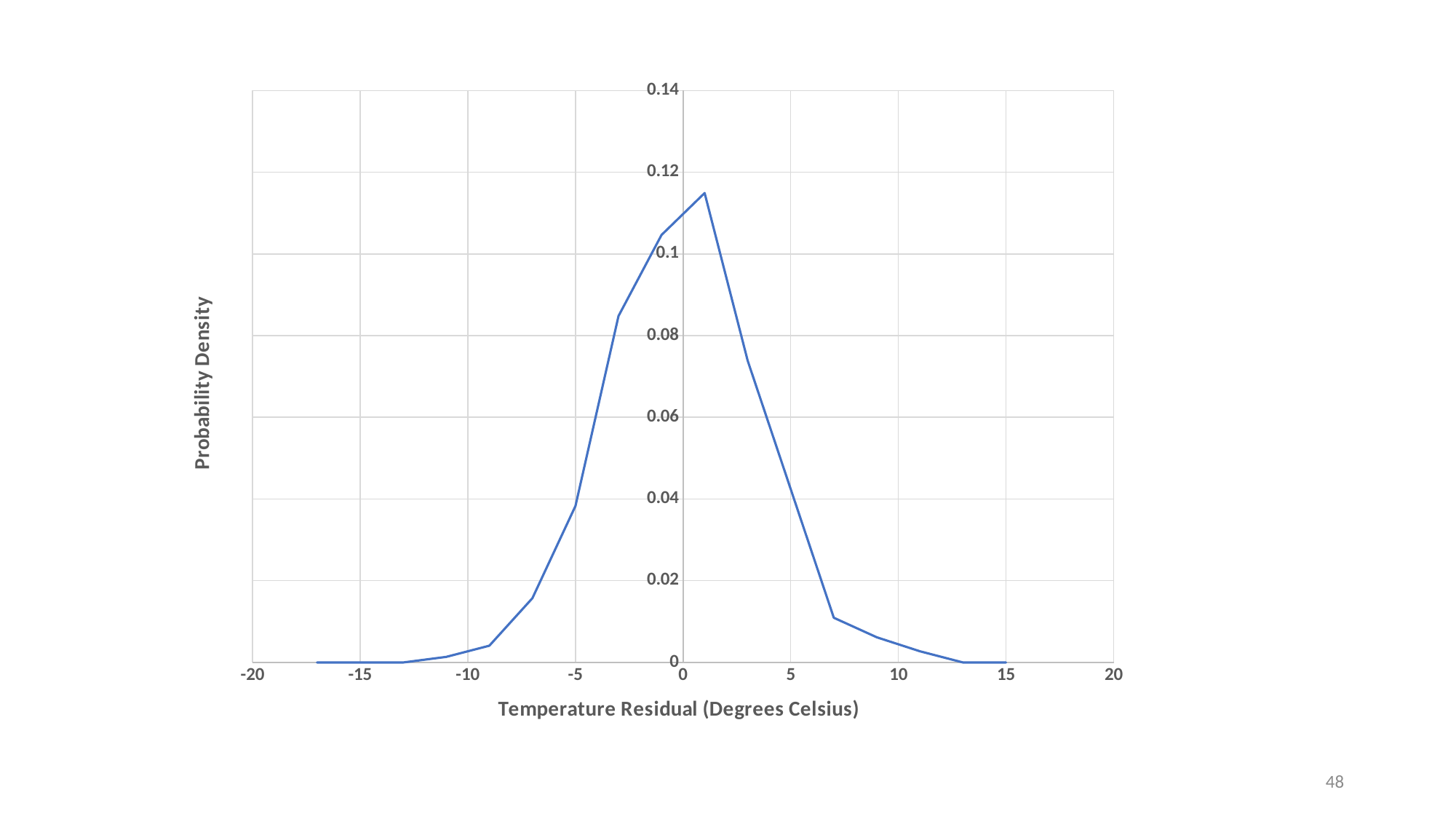
What kind of chart is shown on the slide? line chart What is the title of the y axis? Probability Density Is the probability density at a temperature residual of 3 greater or less than 0.06? greater What is the title of the x axis? Temperature Residual (Degrees Celsius) Is the probability density at a temperature residual of -3 greater or less than 0.08? greater Is the probability density higher at a temperature residual of -3 or at 5? -3 Is the probability density at a temperature residual of -7 greater or less than 0.02? less Does the probability density rise or fall as the temperature residual goes from -15 to 0? rise Does the probability density rise or fall as the temperature residual goes from 0 to 15? fall